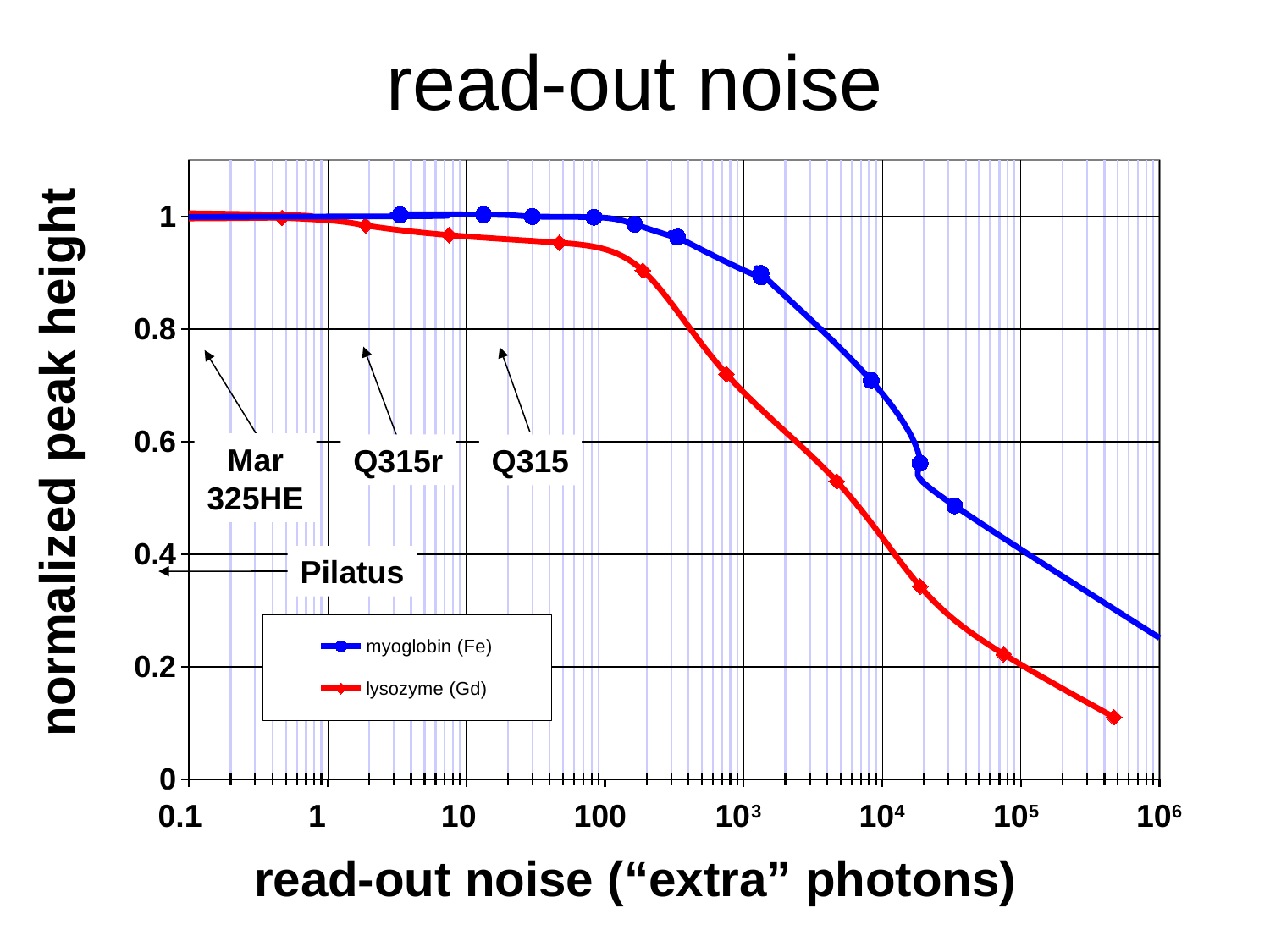
Is the normalized peak height for lysozyme (Gd) at a read-out noise of 10^3 greater or less than 0.8? less Is the normalized peak height for lysozyme (Gd) at a read-out noise of 10^5 greater or less than 0.4? less Is the normalized peak height for myoglobin (Fe) at a read-out noise of 100 greater or less than 0.8? greater Do the values for lysozyme (Gd) rise or fall as read-out noise increases along the x axis? fall What kind of chart is shown on the slide? line chart What is the label of the x axis? read-out noise ("extra" photons) How many series does the legend list? 2 At a read-out noise of 10^5, which series has the lower normalized peak height, myoglobin (Fe) or lysozyme (Gd)? lysozyme (Gd) Do the values for myoglobin (Fe) rise or fall as read-out noise increases along the x axis? fall Which series is drawn in red? lysozyme (Gd) At a read-out noise of 10^3, which series has the higher normalized peak height, myoglobin (Fe) or lysozyme (Gd)? myoglobin (Fe)